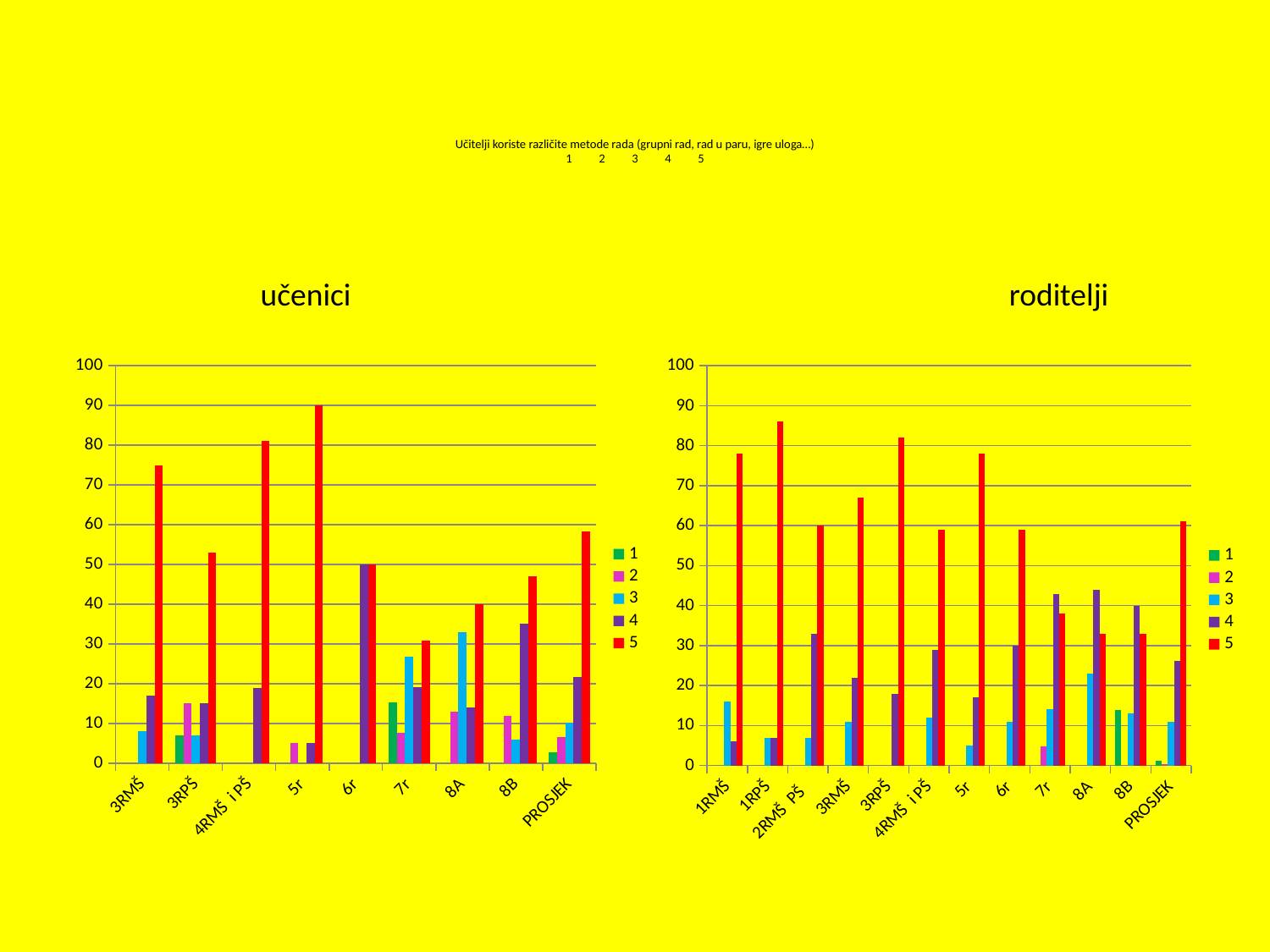
In the 'roditelji' chart, is the value for series 4 at 7r greater or less than 50? less In the 'roditelji' chart, is the value for series 5 at 3RMŠ greater or less than 60? greater What kind of chart is the 'učenici' chart? bar chart In the 'roditelji' chart, which is larger: the series 5 value for 3RPŠ or for 4RMŠ i PŠ? 3RPŠ In the 'učenici' chart, which is larger: the series 5 value for 3RMŠ or for 3RPŠ? 3RMŠ How many series does the legend of the 'roditelji' chart list? 5 In the 'roditelji' chart, which category has the highest value for series 5? 1RPŠ How many categories are shown on the x axis of the 'roditelji' chart? 12 In the 'učenici' chart, which category has the highest value for series 5? 5r In the 'učenici' chart, is the value for series 5 at 4RMŠ i PŠ greater or less than 70? greater How many categories are shown on the x axis of the 'učenici' chart? 9 In the 'učenici' chart, which category has the lowest value for series 5? 7r